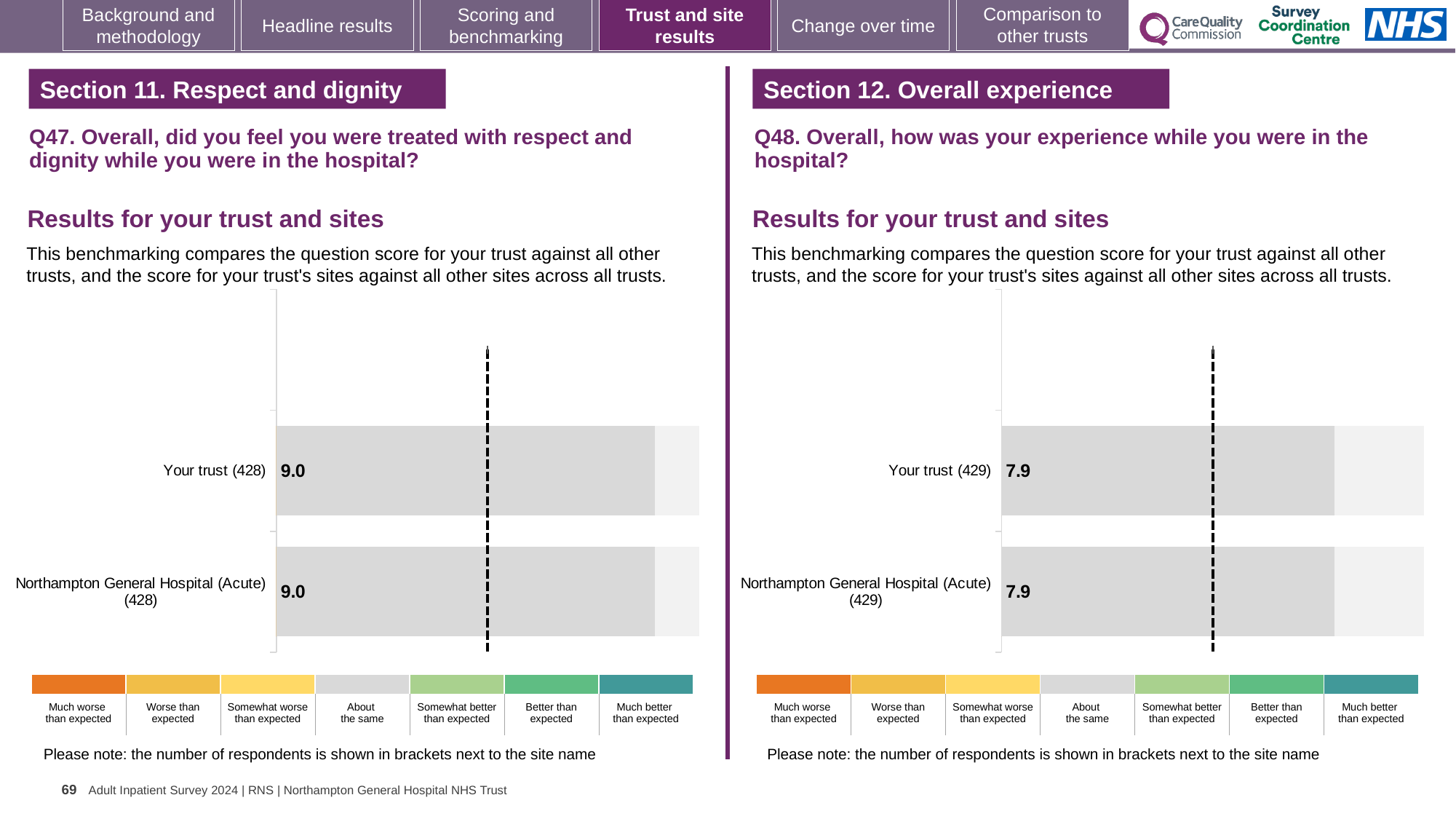
What kind of chart is used in the Q47 section on the left? Bar chart In the Q47 chart on the left, what is the score for Northampton General Hospital (Acute)? 9.0 In the Q48 chart on the right, what is the score for Northampton General Hospital (Acute)? 7.9 In the Q48 chart on the right, what is the score for Your trust? 7.9 How many categories does the colour key below the Q47 chart on the left list? 7 In the Q47 chart on the left, what is the score for Your trust? 9.0 What is the difference between the Your trust score in the Q47 chart on the left and the Your trust score in the Q48 chart on the right? 1.1 Which is larger: the Your trust score in the Q47 chart on the left or the Your trust score in the Q48 chart on the right? Q47 chart (9.0) How many bars are plotted in the Q47 chart on the left? 2 In the Q48 chart on the right, how many respondents are shown in brackets next to Your trust? 429 How many bars are plotted in the Q48 chart on the right? 2